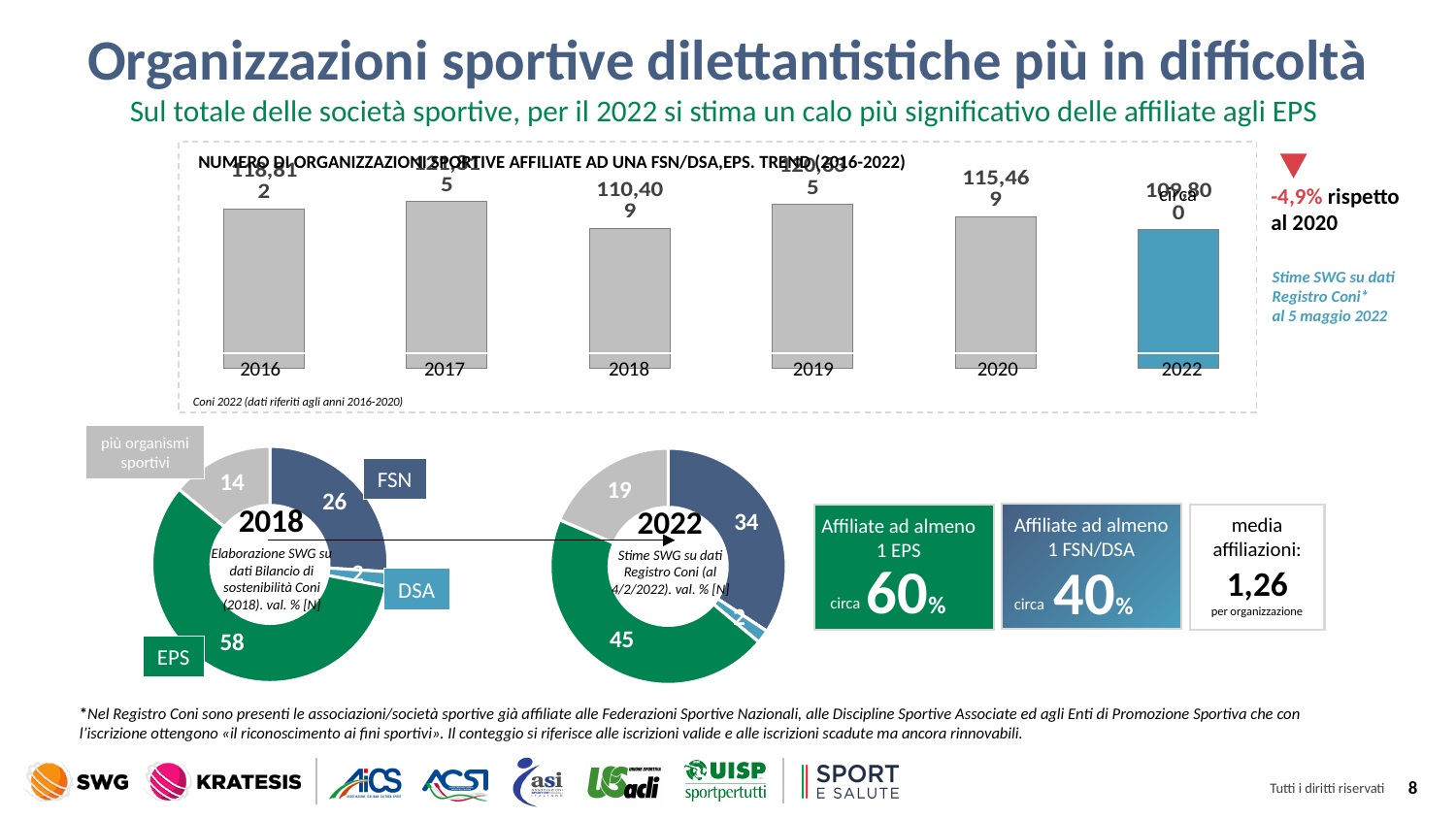
In the top bar chart, what is the difference between the values for 2020 and 2018? 5,060 In the top bar chart, which year has the highest value? 2017 In the top bar chart, how many years (bars) are shown? 6 In the top bar chart, what is the value for 2020? 115,469 In the 2018 donut chart at the bottom left, what is the value for EPS? 58 In the 2018 donut chart at the bottom left, what is the value for FSN? 26 What kind of chart is the top chart titled 'NUMERO DI ORGANIZZAZIONI SPORTIVE AFFILIATE AD UNA FSN/DSA/EPS. TREND (2016-2022)'? bar chart In the top bar chart, which is larger, the value for 2018 or the value for 2020? 2020 In the top bar chart, what is the value for 2018? 110,409 In the top bar chart, which bar is shown in a different colour (blue) from the others? 2022 In the 2022 donut chart at the bottom, what is the value of the largest slice? 45 In the 2018 donut chart at the bottom left, what is the difference between the EPS and FSN values? 32